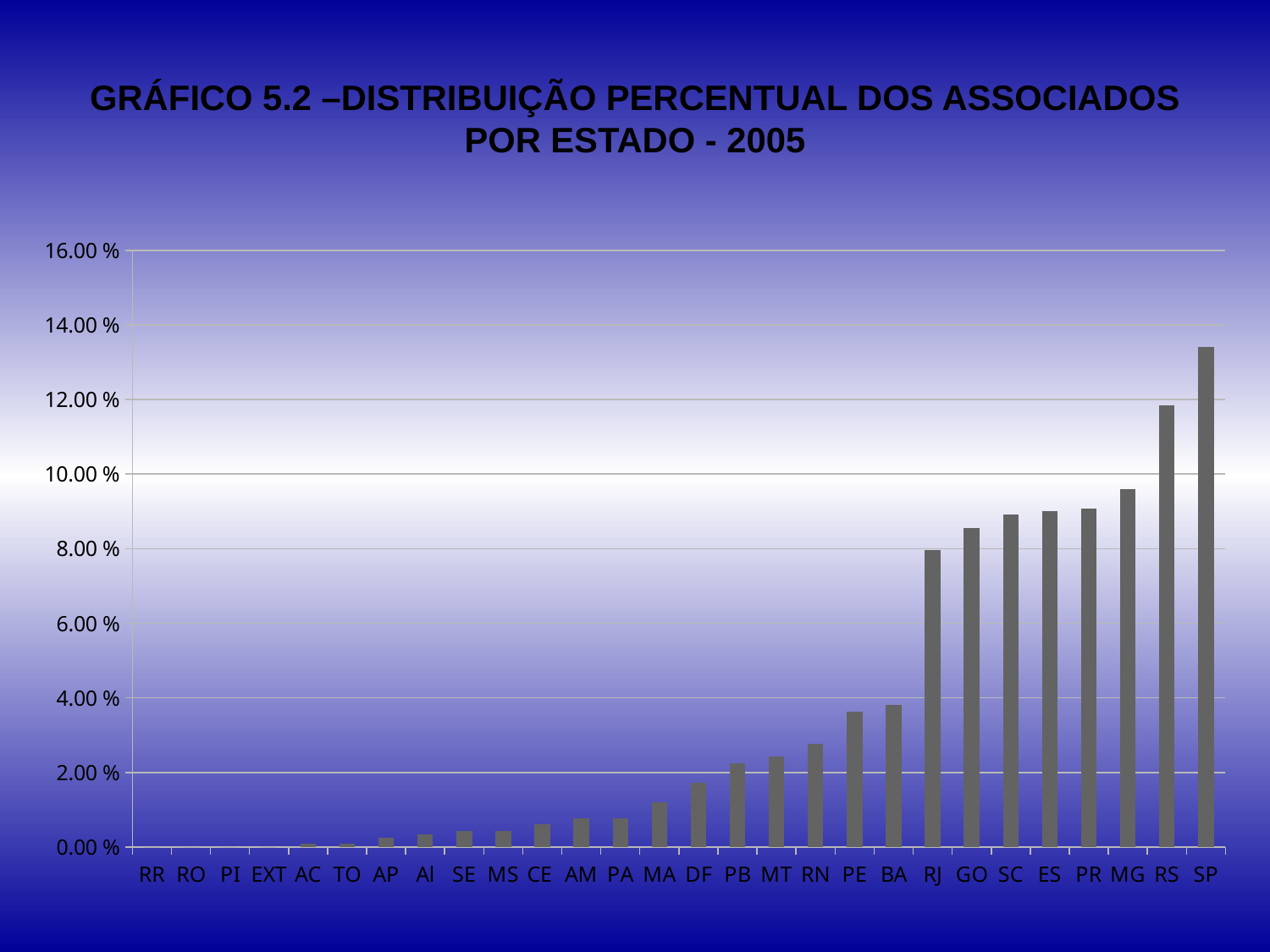
Which state has the highest percentage of associates? SP What kind of chart is shown on the slide? bar chart Which has a larger value, RS or MG? RS Which has a larger value, BA or RJ? RJ How many states/categories are shown along the x axis? 28 Is the value for RJ greater or less than 10.00 %? less Is the value for BA greater or less than 4.00 %? less Is the value for MG greater or less than 8.00 %? greater What is the highest value shown on the vertical axis? 16.00 % Do the values generally rise or fall from left to right along the x axis? rise